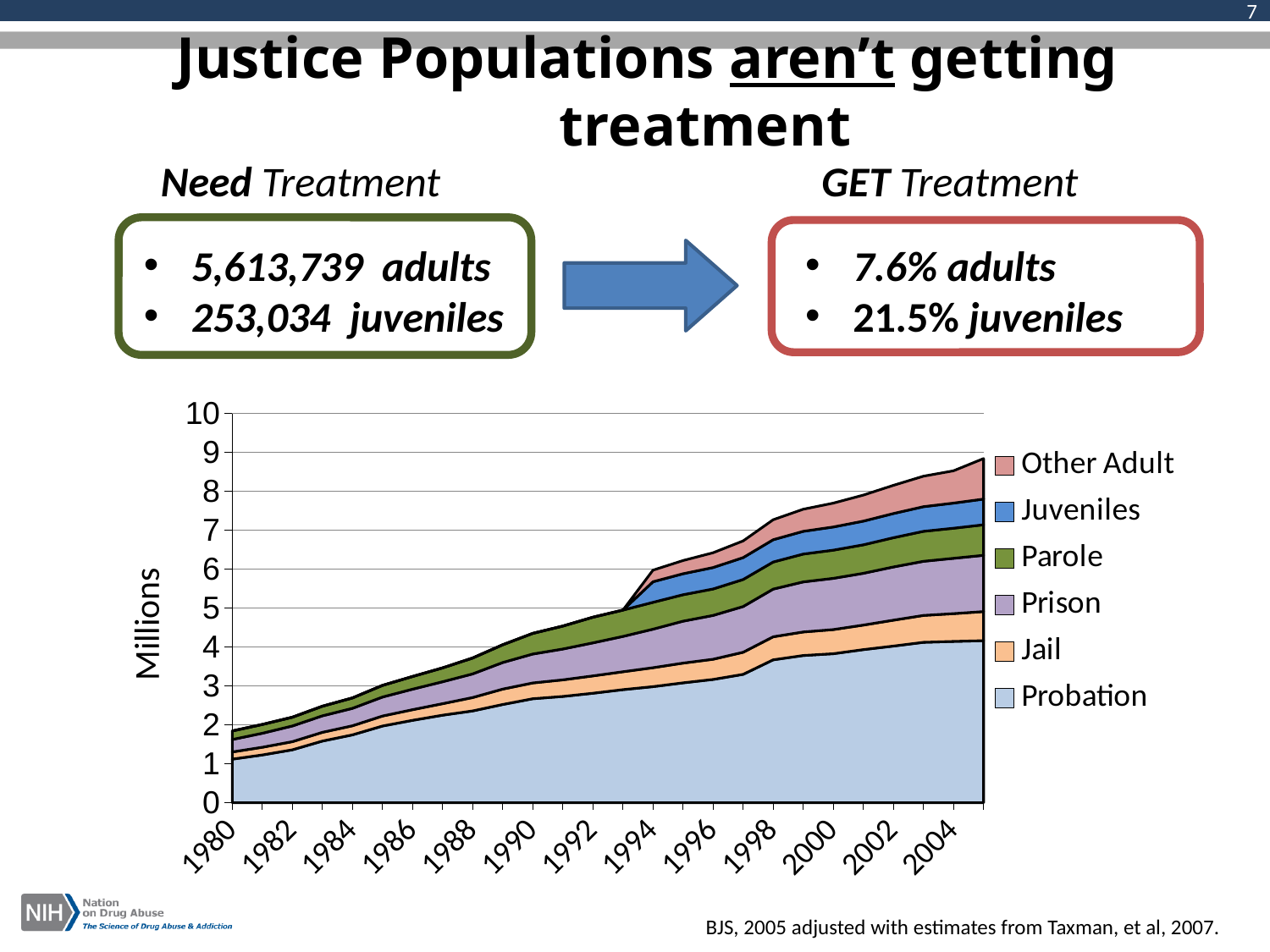
Is the total justice population in 1980 greater or less than 3 million? less What is the label on the chart's y axis? Millions Does the total justice population rise or fall from 1980 to 2004? Rise Which series is listed first (at the top) in the chart's legend? Other Adult Which series accounts for the largest share of the justice population across the chart? Probation How many series does the chart's legend list? 6 Is the total justice population in 2000 greater or less than 7 million? greater Is the total justice population in 1990 greater or less than 4 million? greater How many year labels are shown on the x axis? 13 What kind of chart is shown on the slide? Stacked area chart